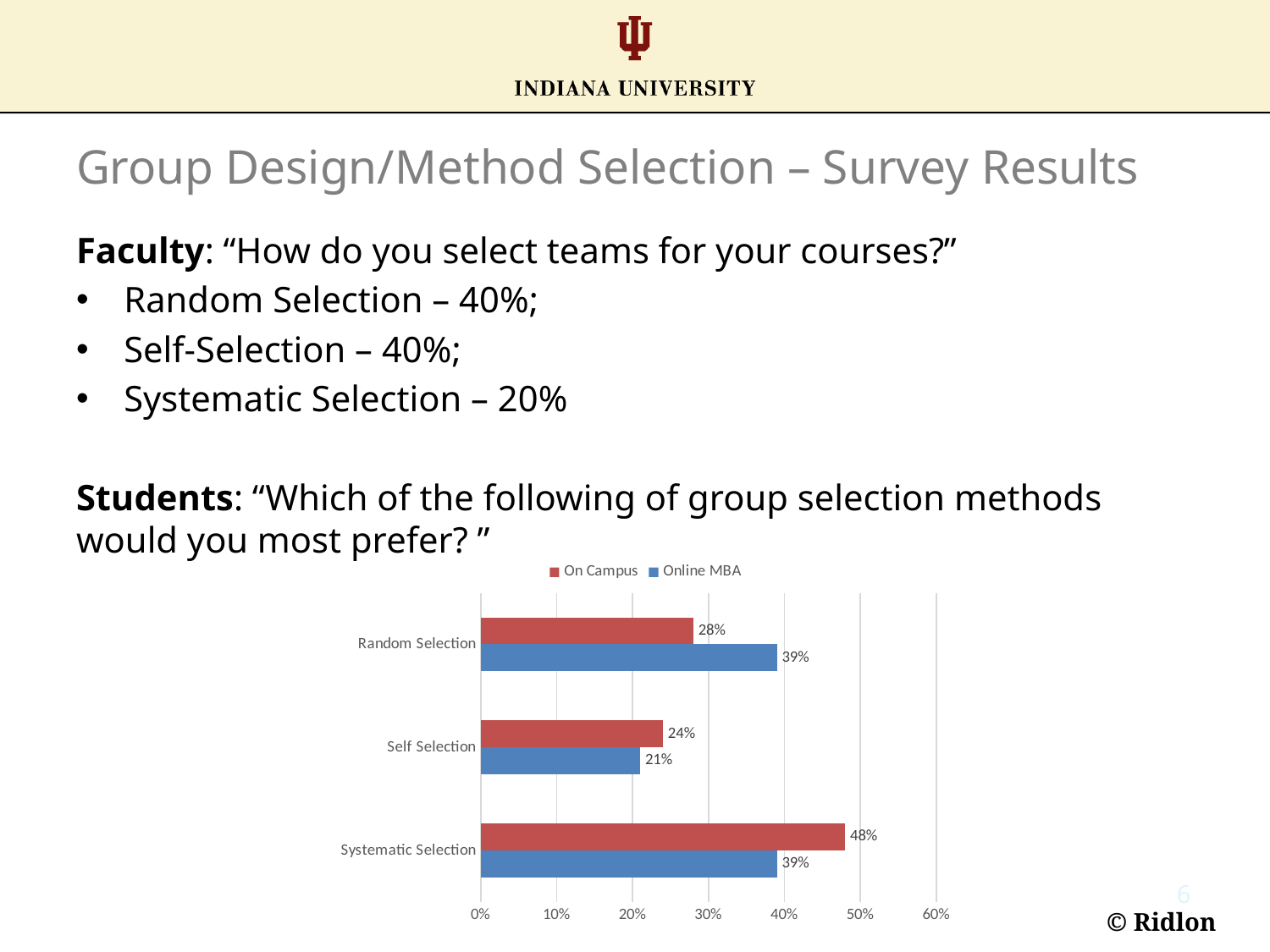
How many series does the legend list? 2 How many categories are shown on the chart? 3 What kind of chart is shown on the slide? bar chart Is the On Campus value for Systematic Selection greater or less than 40%? greater What is the Online MBA value for Self Selection? 21% What is the On Campus value for Random Selection? 28% Which category has the highest On Campus value? Systematic Selection What is the Online MBA value for Systematic Selection? 39% What is the difference between the On Campus and Online MBA values for Random Selection? 11% Which category has the lowest Online MBA value? Self Selection Which series is shown in red in the chart? On Campus Which is larger for Self Selection, the On Campus value or the Online MBA value? On Campus